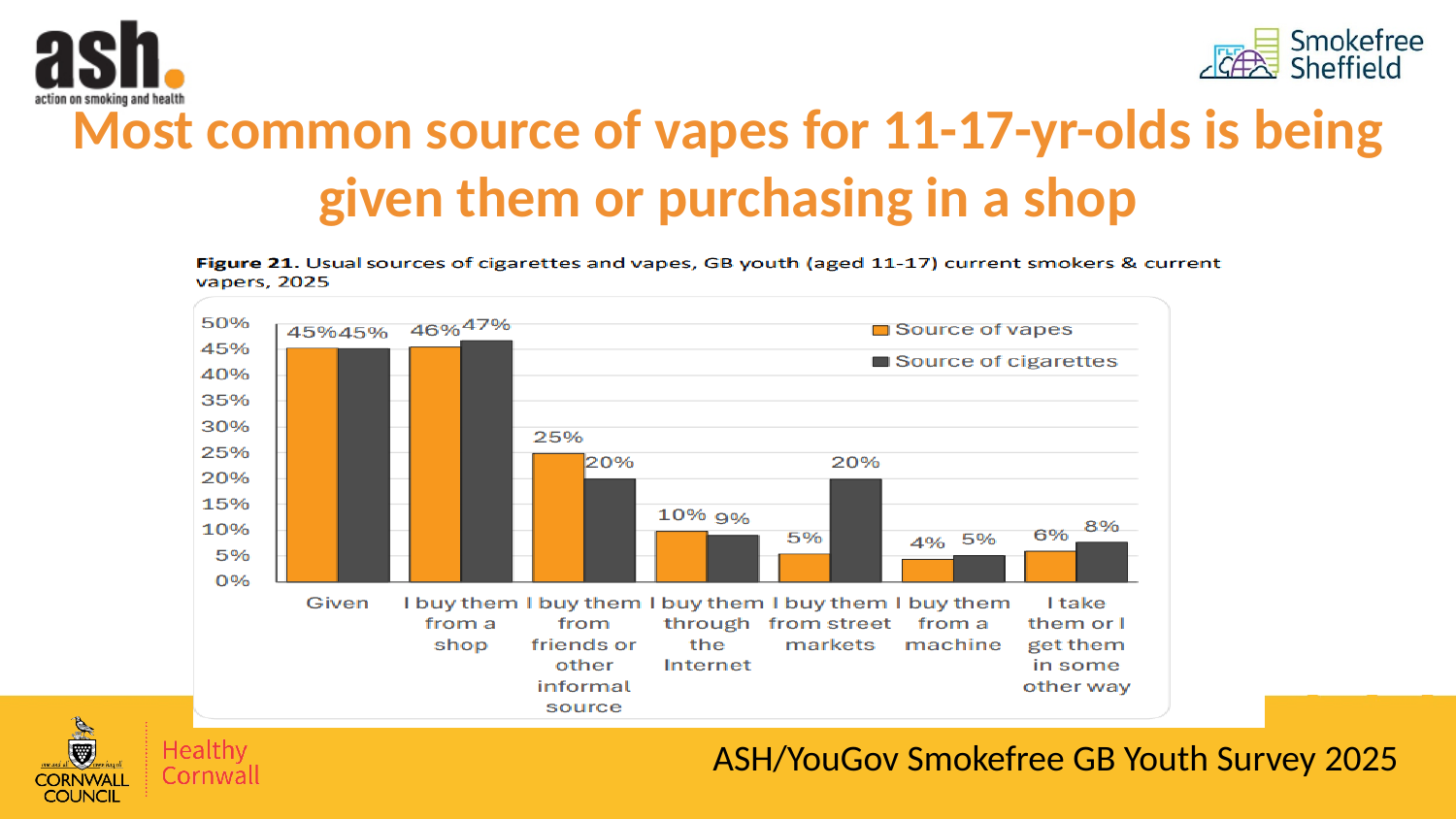
Which colour represents 'Source of vapes' in the chart? Orange How many series does the legend list? 2 What kind of chart is shown on the slide? Bar chart Which category has the highest value for 'Source of vapes'? I buy them from a shop What is the difference between the 'Source of cigarettes' and 'Source of vapes' values for 'I buy them from street markets'? 15% For 'I buy them through the Internet', which is larger: the 'Source of vapes' value or the 'Source of cigarettes' value? Source of vapes Which category has the lowest value for 'Source of vapes'? I buy them from a machine How many source categories are shown on the x axis? 7 What is the value for 'Source of cigarettes' in the 'I buy them from street markets' category? 20% What percentage of young vapers say their usual source of vapes is being given them? 45% What is the value for 'Source of cigarettes' in the 'I buy them from a shop' category? 47% What is the value for 'Source of vapes' in the 'I buy them from friends or other informal source' category? 25%